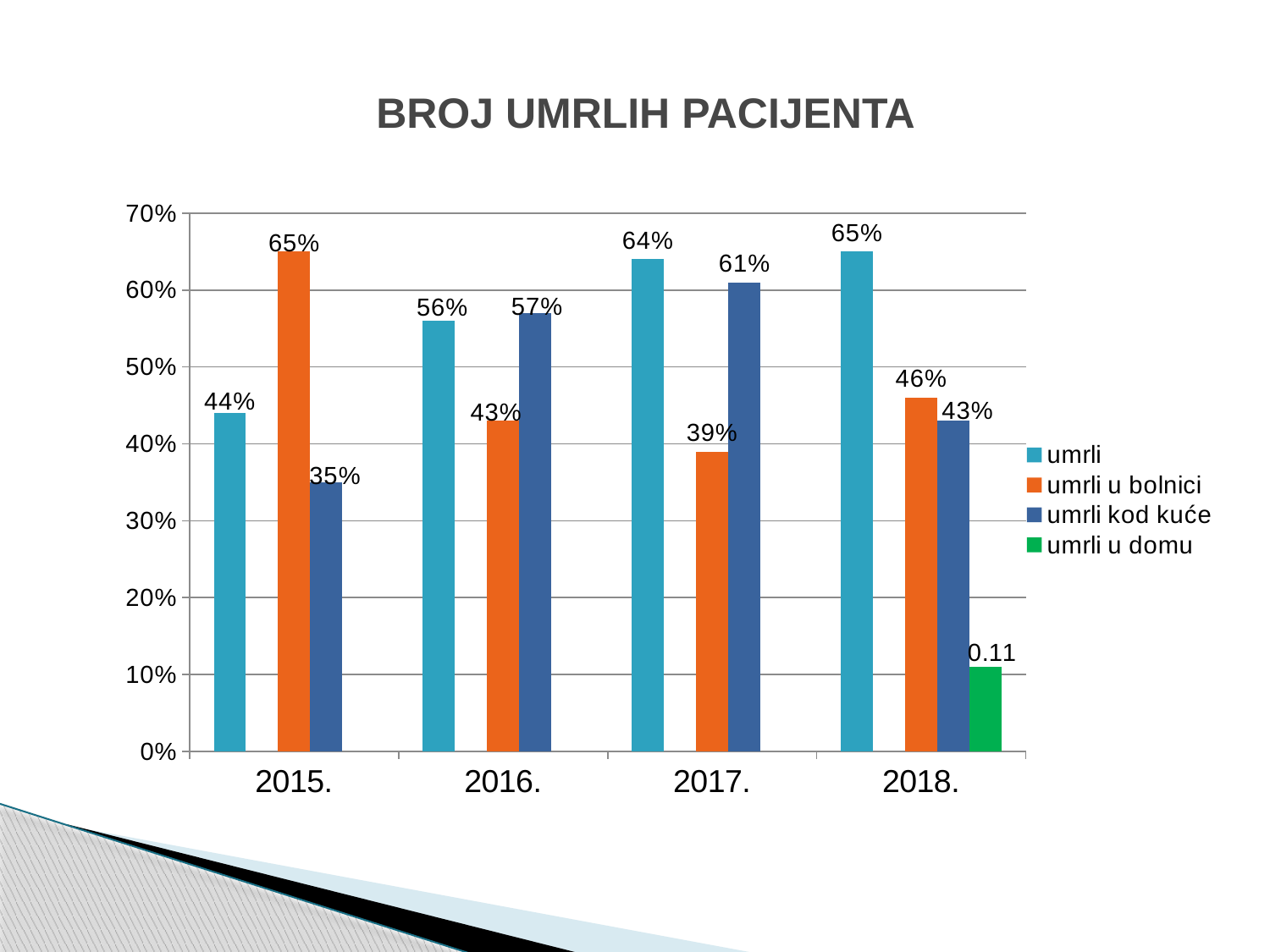
What is the value for "umrli" in 2016.? 56% How many years are shown on the x axis? 4 What is the value for "umrli u domu" in 2018.? 0.11 What is the value for "umrli u bolnici" in 2015.? 65% What is the title of the chart? BROJ UMRLIH PACIJENTA In which year is the value for "umrli u bolnici" lowest? 2017. How many series does the legend list? 4 What is the value for "umrli kod kuće" in 2017.? 61% What kind of chart is shown on the slide? bar chart Which is larger in 2016.: "umrli u bolnici" or "umrli kod kuće"? umrli kod kuće What is the difference between the "umrli" value in 2018. and the "umrli" value in 2015.? 21% In which year is the value for "umrli kod kuće" highest? 2017.